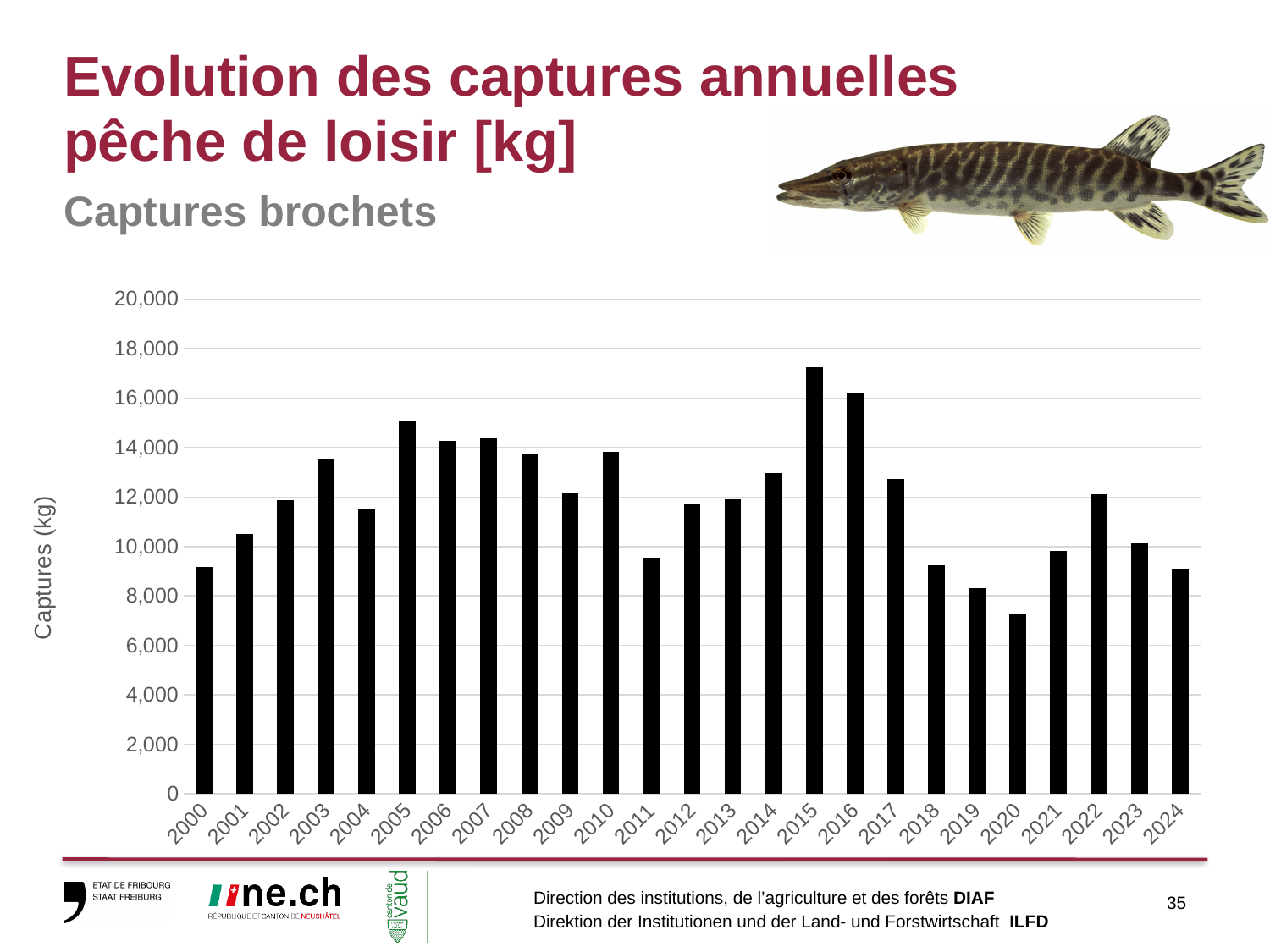
What is the label of the vertical axis of the chart? Captures (kg) Is the value for 2005 greater or less than 14,000? greater Do the values rise or fall from 2016 to 2020? fall Which year has the larger catch, 2015 or 2016? 2015 How many years are plotted on the x axis of the chart? 25 Which year has the larger catch, 2020 or 2021? 2021 What kind of chart is shown on the slide? bar chart Which year has the highest pike catch in the chart? 2015 Which year has the lowest pike catch in the chart? 2020 Is the value for 2015 greater or less than 16,000? greater Is the value for 2011 greater or less than 10,000? less